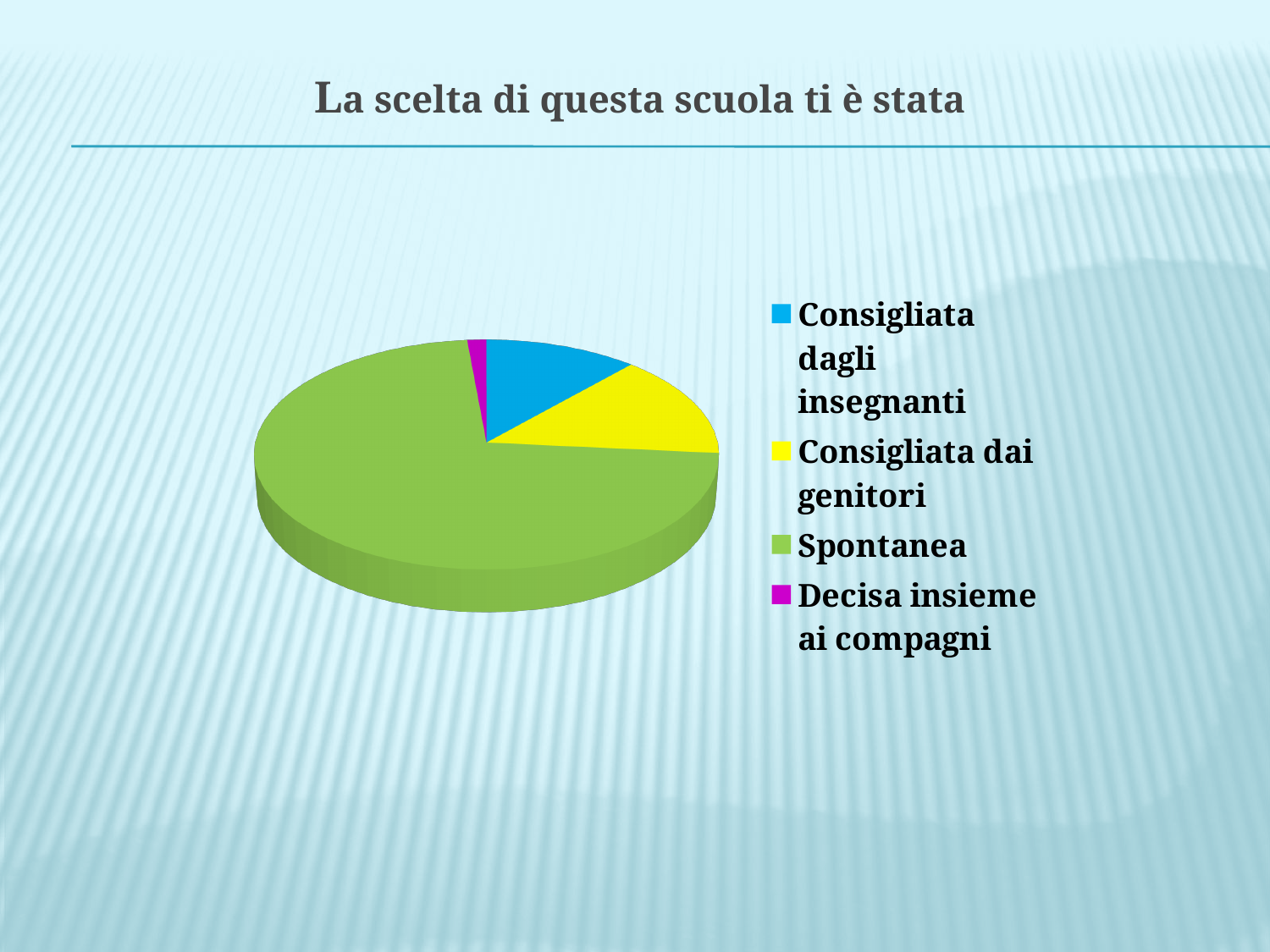
How many categories does the pie chart show? 4 Which is smaller: the slice for Consigliata dai genitori or the slice for Decisa insieme ai compagni? Decisa insieme ai compagni What kind of chart is shown on the slide? pie chart Which is larger: the slice for Spontanea or the slice for Consigliata dagli insegnanti? Spontanea Which category has the largest slice of the pie? Spontanea Which is larger: the slice for Spontanea or the slice for Consigliata dai genitori? Spontanea What is the title of the slide containing the pie chart? La scelta di questa scuola ti è stata What colour is the slice for Spontanea in the pie chart? green Which category has the smallest slice of the pie? Decisa insieme ai compagni